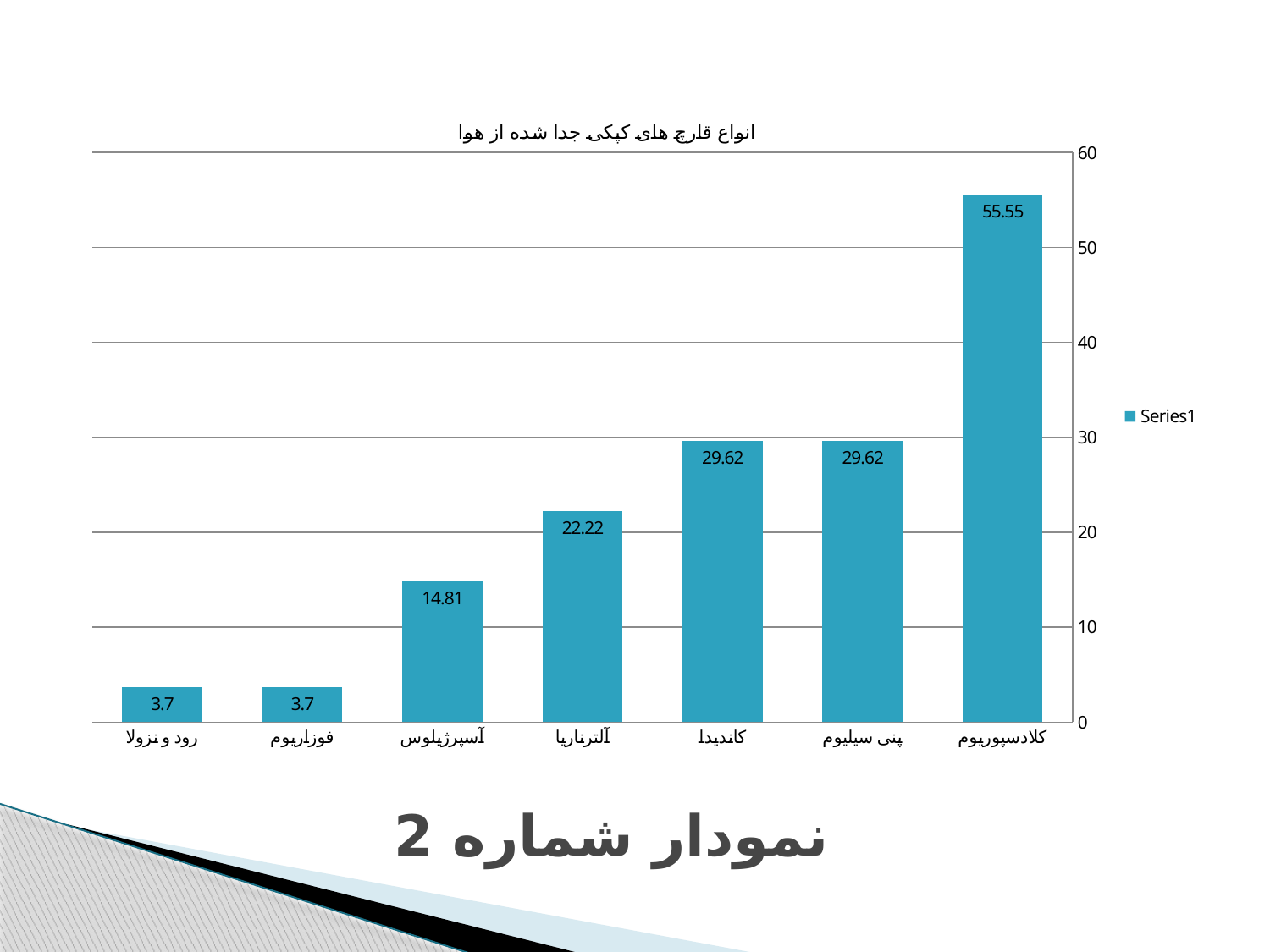
What is the value for پنی سیلیوم? 29.62 What is the value for آلترناریا? 22.22 Which category has the highest value? کلادسپوریوم What is the value for آسپرژیلوس? 14.81 What kind of chart is shown on the slide? bar chart How many categories are shown on the x axis? 7 How many series does the legend list? 1 What is the difference between the values for کلادسپوریوم and کاندیدا? 25.93 What is the title of the chart? انواع قارچ های کپکی جدا شده از هوا What is the difference between the values for آلترناریا and آسپرژیلوس? 7.41 Which is larger, the value for آلترناریا or the value for فوزاریوم? آلترناریا What is the value for کلادسپوریوم? 55.55